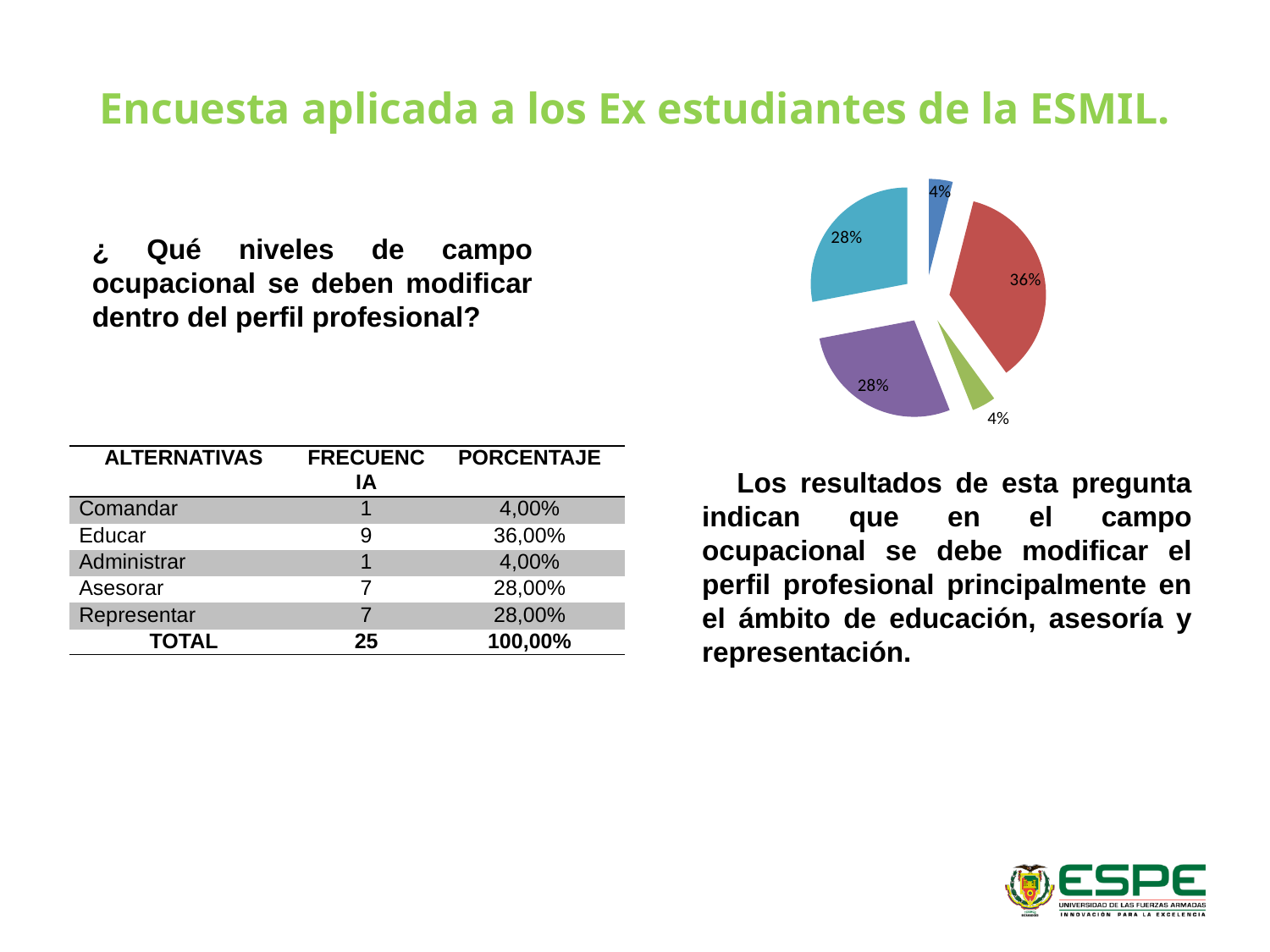
What colour is the largest slice of the pie chart? red What kind of chart is shown on the slide? pie chart Which is larger in the pie chart, the red slice or the purple slice? the red slice How many slices of the pie chart are labelled 28%? 2 What is the smallest percentage shown on the pie chart? 4% What is the largest percentage shown on the pie chart? 36% What percentage is labelled on the green slice of the pie chart? 4% What percentage is labelled on the red slice of the pie chart? 36% What is the difference in percentage points between the largest slice (36%) and a 28% slice? 8 What percentage is labelled on the purple slice of the pie chart? 28% How many slices does the pie chart have? 5 How many slices of the pie chart are labelled 4%? 2